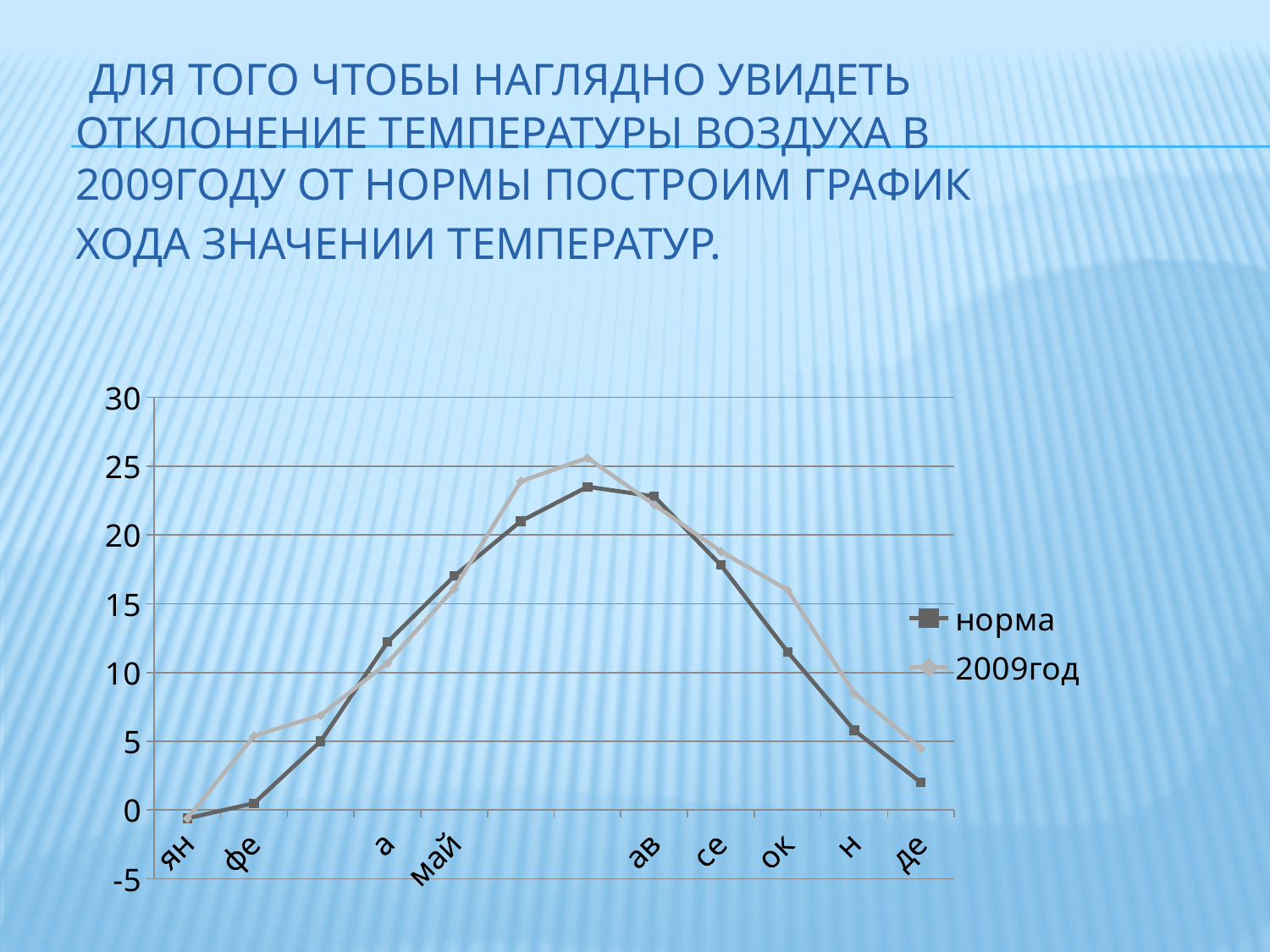
What are the two series named in the legend? норма and 2009год For ок, which series has the larger value, норма or 2009год? 2009год Does the норма line rise or fall from ян to май? rise How many data points does each line have? 12 What kind of chart is shown on the slide? line chart For фе, which series has the larger value, норма or 2009год? 2009год Is the value of норма for де greater or less than 5? less Does the 2009год line rise or fall from ав to де? fall Is the value of 2009год for н greater or less than 10? less Is the value of норма for а greater or less than 10? greater How many series does the legend list? 2